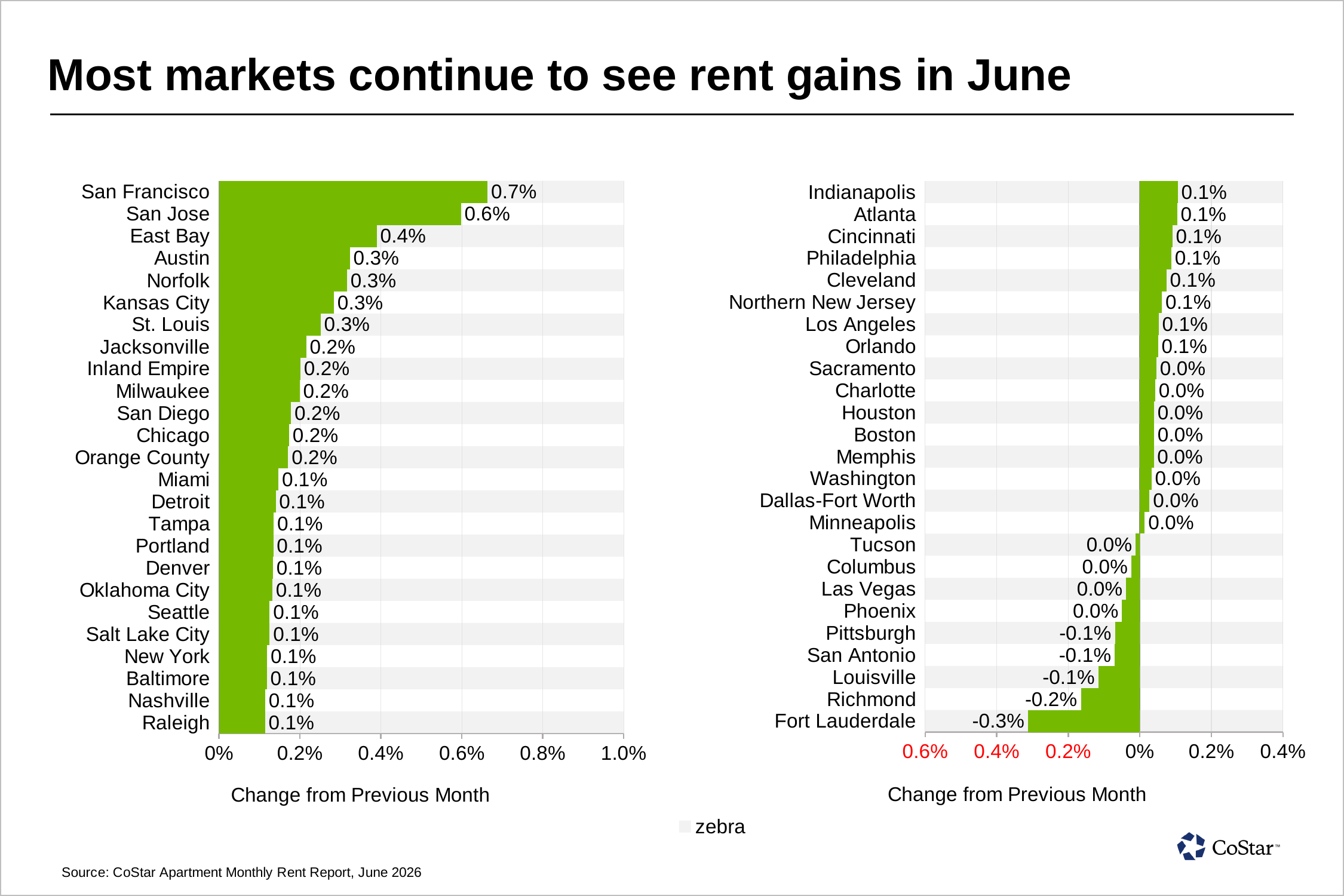
On the right chart, what is the change from previous month for Fort Lauderdale? -0.3% On the right chart, what is the value shown for Richmond? -0.2% How many markets are listed on the left chart? 25 On the left chart, which is larger, the value for San Jose or the value for East Bay? San Jose On the left chart, what is the value shown for East Bay? 0.4% How many markets are listed on the right chart? 25 On the left chart, what is the difference between the values for San Francisco and San Jose? 0.1% On the left chart, what is the change from previous month for San Francisco? 0.7% What is the x-axis title of the right chart? Change from Previous Month On the left chart, which market has the highest change from previous month? San Francisco What kind of chart is the left chart? Bar chart On the right chart, which market has the lowest change from previous month? Fort Lauderdale